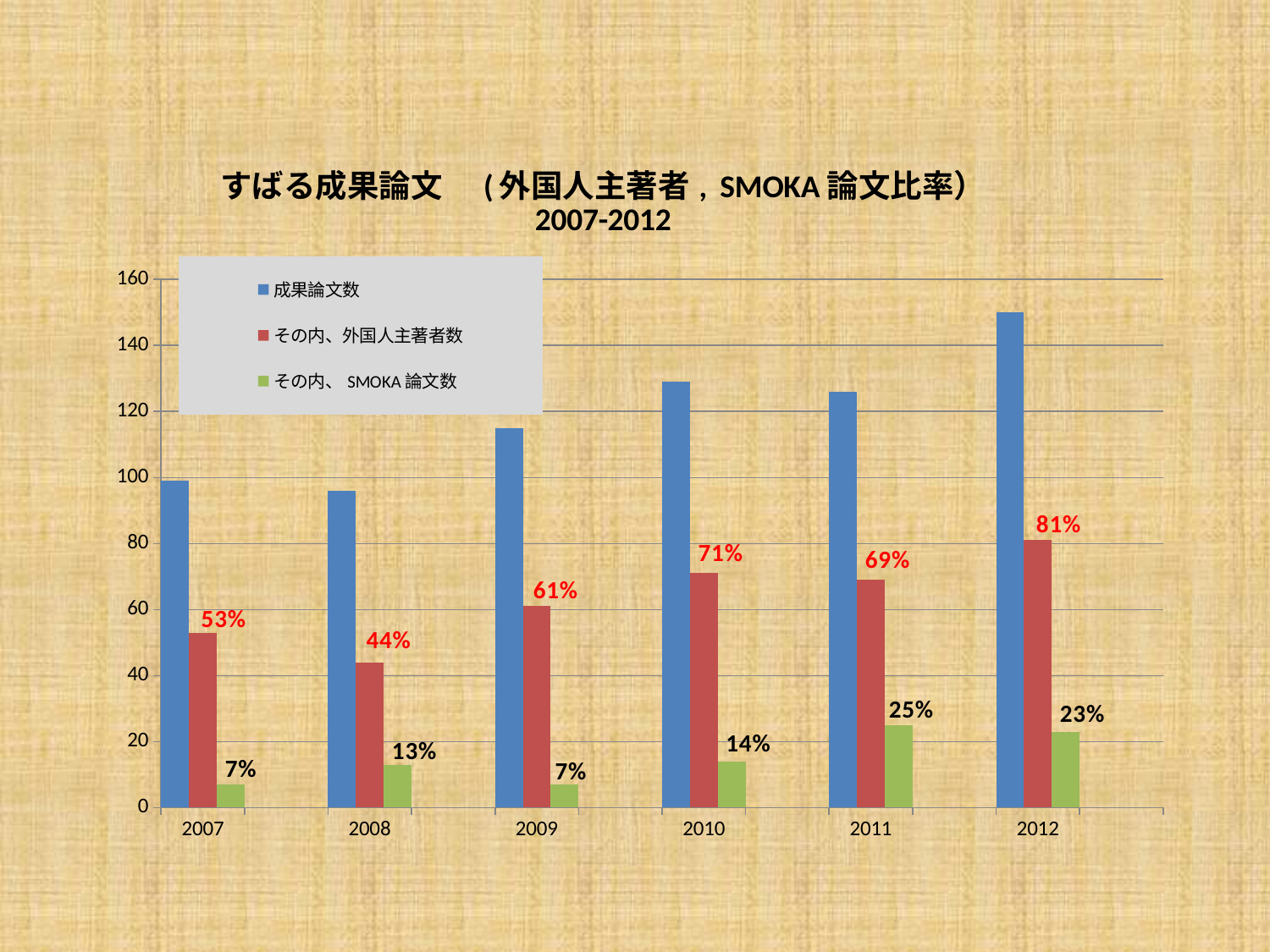
Which year has the highest labelled value for その内、 SMOKA 論文数? 2011 Which year has the lowest labelled value for その内、外国人主著者数? 2008 How many years are shown on the x axis? 6 What label is printed on the その内、 SMOKA 論文数 bar for 2011? 25% Which colour represents その内、 SMOKA 論文数 in the legend? green Is the 成果論文数 value for 2012 greater or less than 140? greater How many series does the legend list? 3 What label is printed on the その内、外国人主著者数 bar for 2012? 81% Is the 成果論文数 value for 2008 greater or less than 100? less Which year has the highest 成果論文数 bar? 2012 What label is printed on the その内、外国人主著者数 bar for 2008? 44% What type of chart is shown on the slide? bar chart